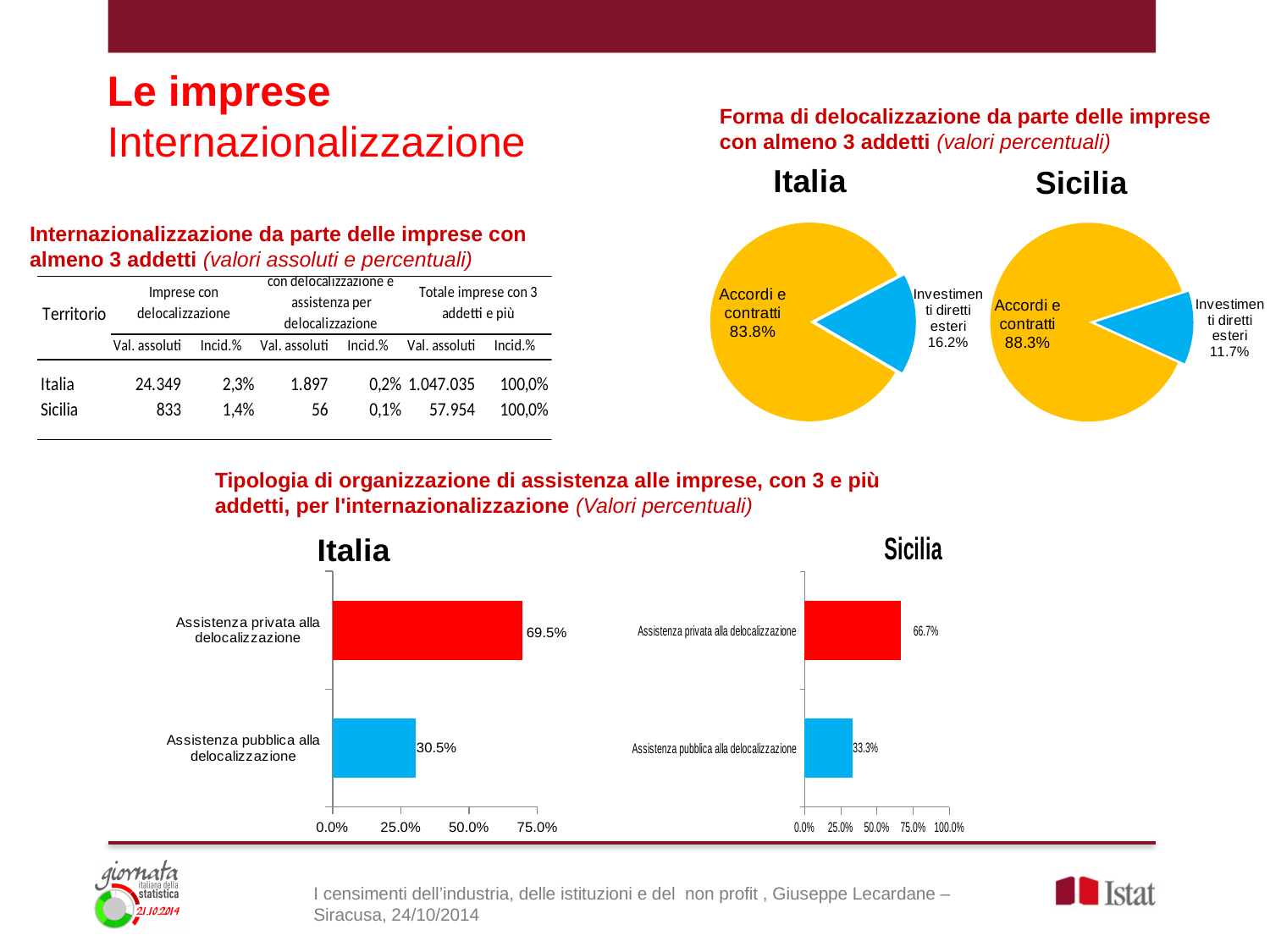
In the Italia pie chart under 'Forma di delocalizzazione', what share is 'Accordi e contratti'? 83.8% In the Sicilia pie chart under 'Forma di delocalizzazione', which slice is the largest? Accordi e contratti In the Italia bar chart under 'Tipologia di organizzazione di assistenza', what is the value for 'Assistenza privata alla delocalizzazione'? 69.5% In the Italia pie chart under 'Forma di delocalizzazione', what is the value for 'Investimenti diretti esteri'? 16.2% In the Sicilia bar chart under 'Tipologia di organizzazione di assistenza', what is the difference between 'Assistenza privata alla delocalizzazione' and 'Assistenza pubblica alla delocalizzazione'? 33.4% In the Sicilia pie chart under 'Forma di delocalizzazione', what share is 'Investimenti diretti esteri'? 11.7% What type of chart is used for 'Tipologia di organizzazione di assistenza alle imprese'? Bar chart How many slices does the Italia pie chart under 'Forma di delocalizzazione' have? 2 What type of chart is used for 'Forma di delocalizzazione da parte delle imprese con almeno 3 addetti'? Pie chart In the Italia bar chart under 'Tipologia di organizzazione di assistenza', which category has the lowest value? Assistenza pubblica alla delocalizzazione In the Italia bar chart under 'Tipologia di organizzazione di assistenza', what is the value for 'Assistenza pubblica alla delocalizzazione'? 30.5% In the Sicilia bar chart under 'Tipologia di organizzazione di assistenza', what is the value for 'Assistenza pubblica alla delocalizzazione'? 33.3%